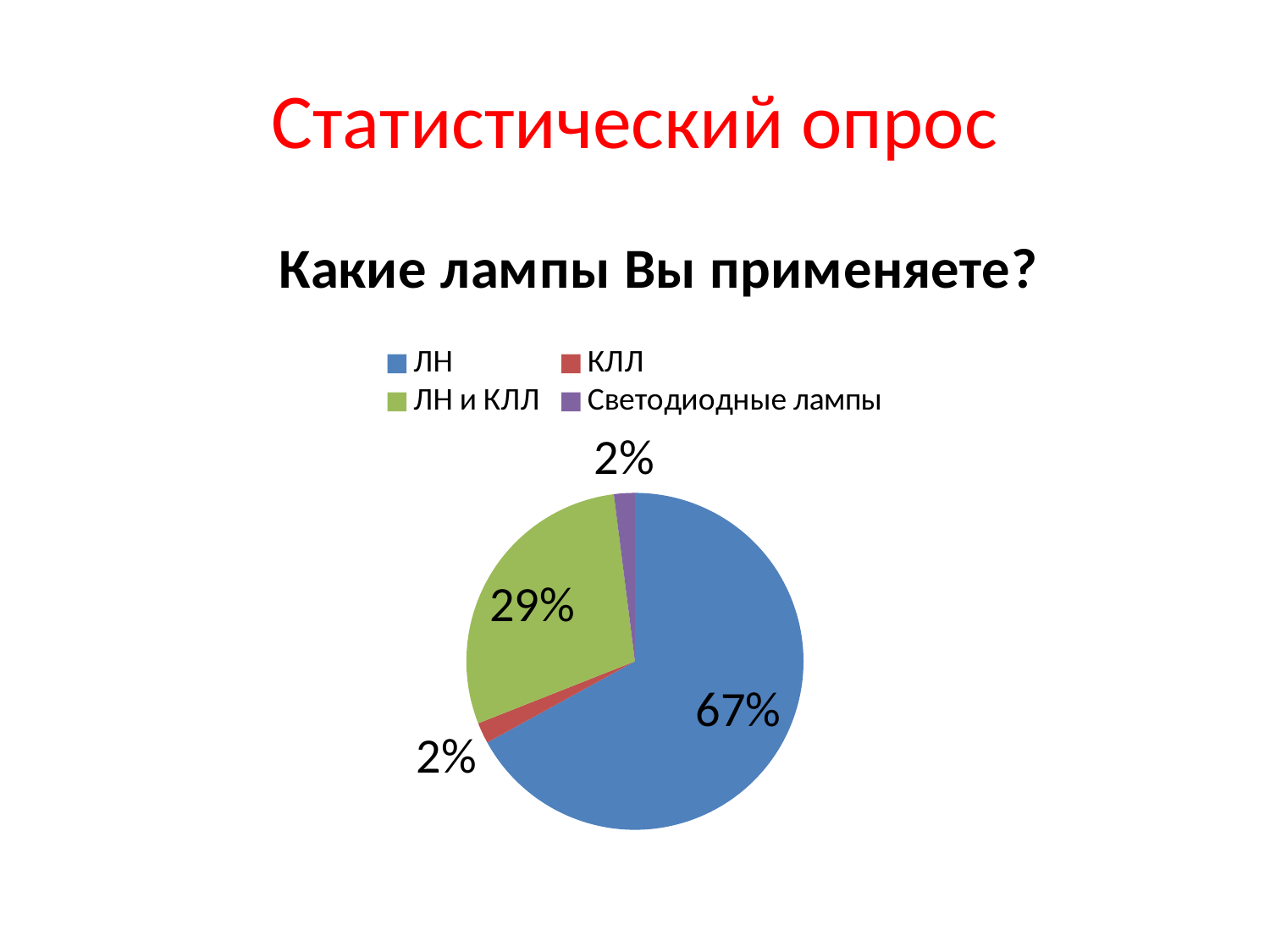
What share of the pie does ЛН have? 67% What share of the pie does КЛЛ have? 2% What share of the pie does ЛН и КЛЛ have? 29% Is the share of ЛН greater or less than 50%? greater Which category has the largest slice of the pie? ЛН Which is larger, the share of ЛН и КЛЛ or the share of КЛЛ? ЛН и КЛЛ What is the title of the chart? Какие лампы Вы применяете? How many categories does the legend list? 4 What is the difference between the shares of ЛН and ЛН и КЛЛ? 38% What type of chart is shown on the slide? pie chart What colour is the slice for ЛН и КЛЛ? green